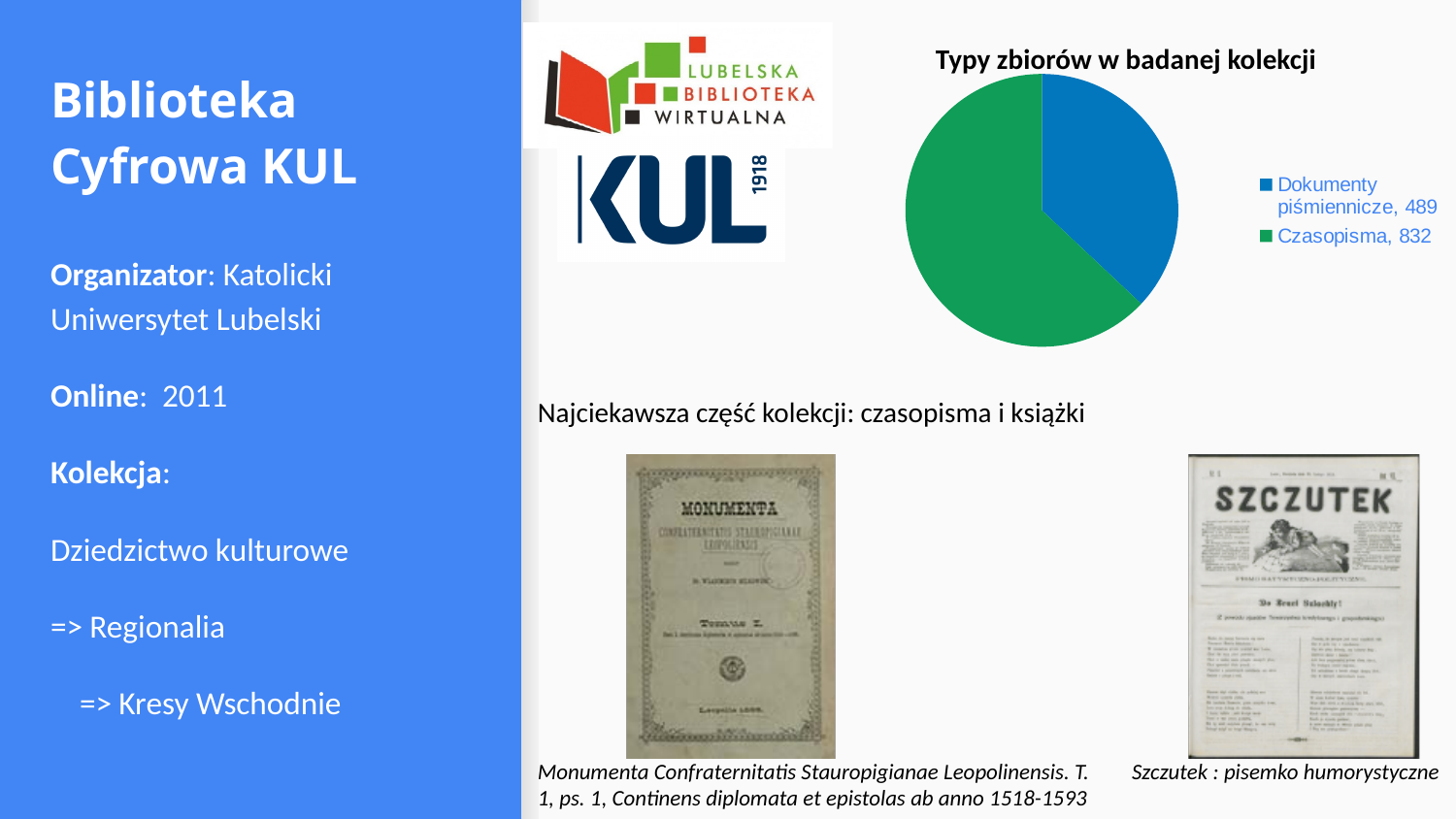
What is the value for Dokumenty piśmiennicze in the pie chart? 489 Which category has the smallest slice in the pie chart? Dokumenty piśmiennicze Which category has the largest slice in the pie chart? Czasopisma What is the total of the two values shown in the pie chart? 1321 What is the title of the chart on the slide? Typy zbiorów w badanej kolekcji What type of chart is shown on the slide? Pie chart What is the difference between the values for Czasopisma and Dokumenty piśmiennicze? 343 What is the value for Czasopisma in the pie chart? 832 What colour is the Czasopisma slice in the pie chart? Green Which is larger, the value for Czasopisma or the value for Dokumenty piśmiennicze? Czasopisma How many categories does the pie chart show? 2